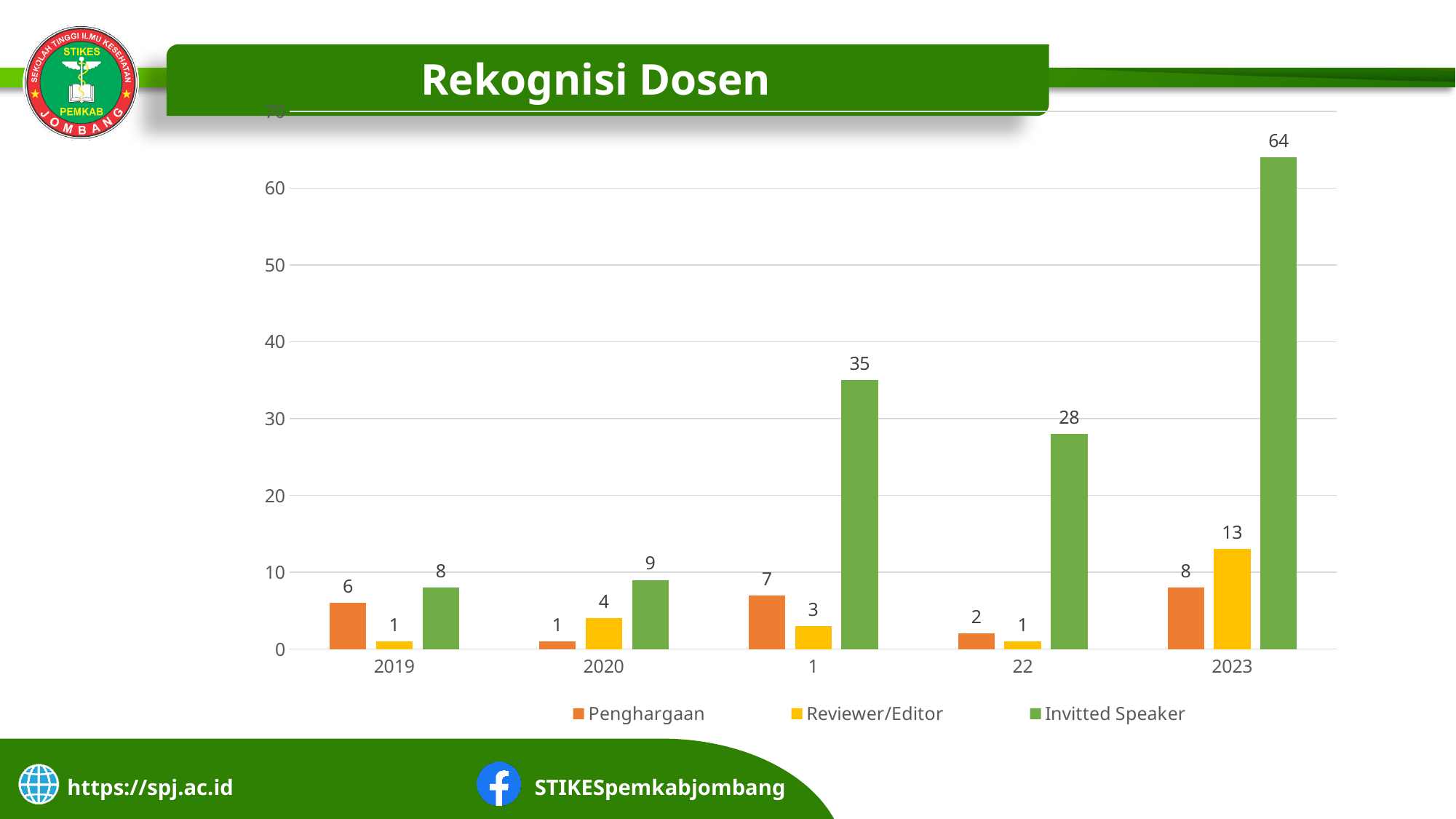
Which category has the lowest Penghargaan value? 2020 How many categories are shown on the x axis? 5 Is the Invitted Speaker value for the category labelled 22 greater or less than 20? greater Which category has the highest Invitted Speaker value? 2023 What is the value for Reviewer/Editor in 2020? 4 What is the value for Penghargaan in 2019? 6 What is the difference between the Invitted Speaker values for 2023 and the category labelled 1? 29 What is the title of the chart? Rekognisi Dosen What is the value for Invitted Speaker in 2023? 64 What kind of chart is shown on the slide? bar chart How many series does the legend list? 3 Which is larger, the Reviewer/Editor value for 2023 or the Penghargaan value for 2023? Reviewer/Editor